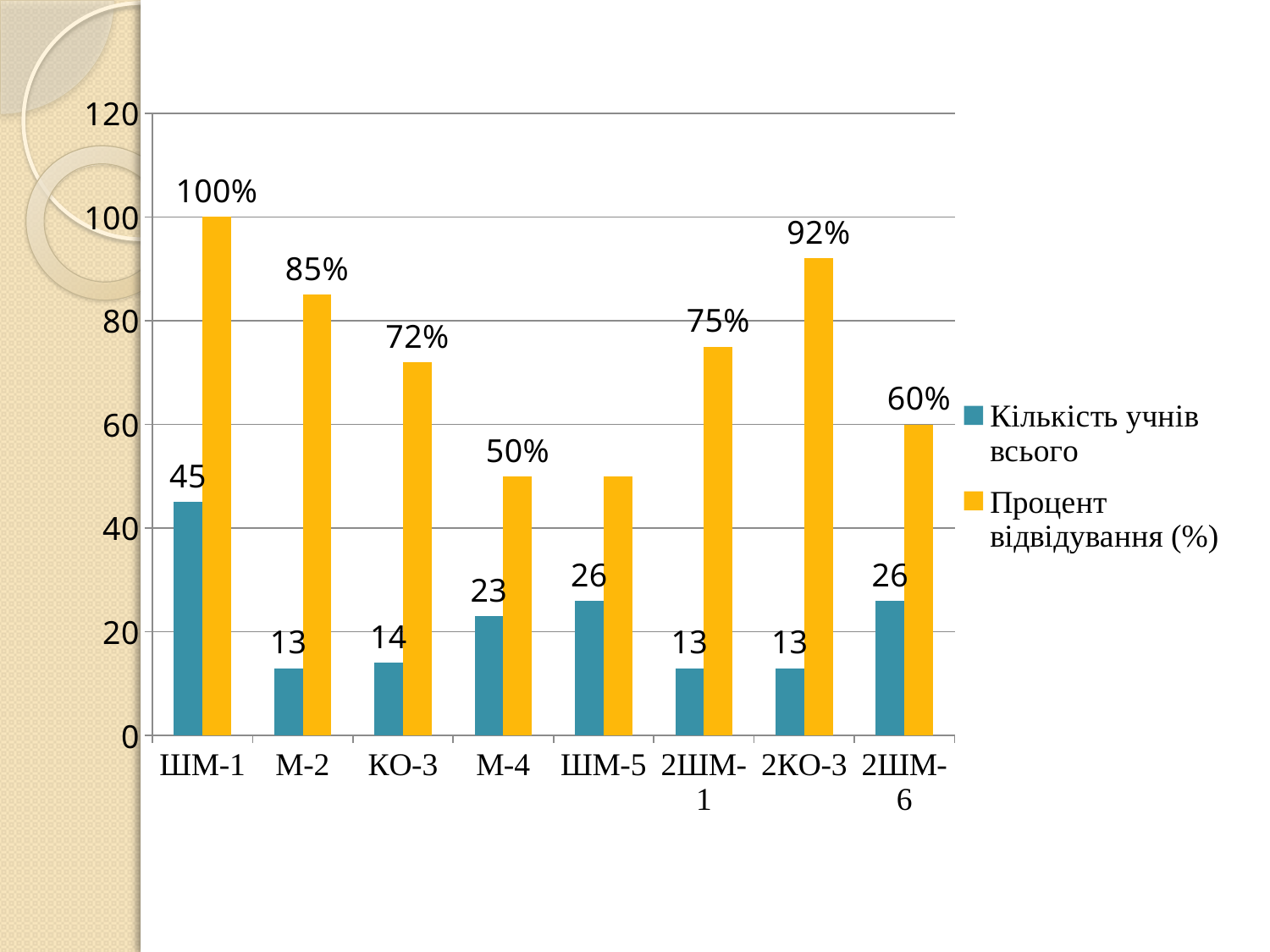
How many categories are shown on the x axis? 8 Is the Процент відвідування (%) value for ШМ-5 greater or less than 40? greater What is the Процент відвідування (%) for 2КО-3? 92% How many series does the legend list? 2 What is the value of Кількість учнів всього for ШМ-1? 45 Which has a larger Кількість учнів всього, М-4 or ШМ-5? ШМ-5 Which category has the highest Процент відвідування (%)? ШМ-1 What is the difference in Кількість учнів всього between ШМ-1 and М-4? 22 What kind of chart is shown on the slide? bar chart What is the value of Кількість учнів всього for 2ШМ-6? 26 Which category has the highest Кількість учнів всього? ШМ-1 What is the difference between the Процент відвідування (%) for ШМ-1 and for 2ШМ-6? 40%